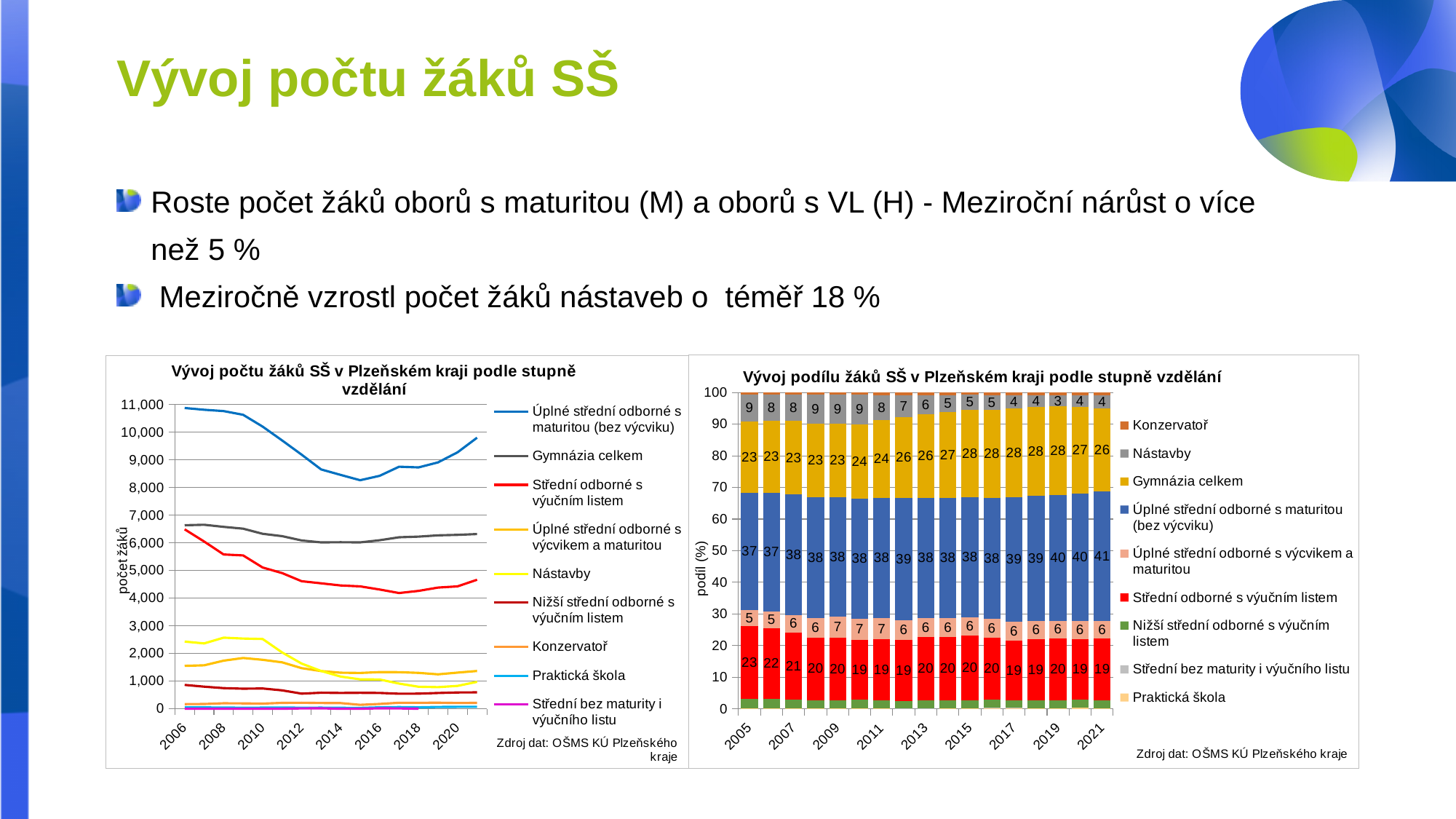
How many years (bars) are shown on the x axis of the right chart? 17 In the right chart, what is the share of 'Gymnázia celkem' in 2005? 23 How many series does the legend of the left chart list? 9 In the right chart, by how many percentage points did the share of 'Střední odborné s výučním listem' change between 2005 (23) and 2021 (19)? 4 In the left chart, is the value for 'Střední odborné s výučním listem' in 2018 greater or less than 5,000? less In the left chart, is the value for 'Úplné střední odborné s maturitou (bez výcviku)' in 2006 greater or less than 10,000? greater In the left chart, does the 'Nástavby' series rise or fall overall from 2006 to 2020? fall In the right chart, what is the share of 'Nástavby' in 2021? 4 In the right chart, what is the share of 'Úplné střední odborné s maturitou (bez výcviku)' in 2021? 41 What kind of chart is the left chart, 'Vývoj počtu žáků SŠ v Plzeňském kraji podle stupně vzdělání'? line chart What kind of chart is the right chart, 'Vývoj podílu žáků SŠ v Plzeňském kraji podle stupně vzdělání'? stacked bar chart In the right chart, which is larger in 2021: the share of 'Gymnázia celkem' or the share of 'Střední odborné s výučním listem'? Gymnázia celkem